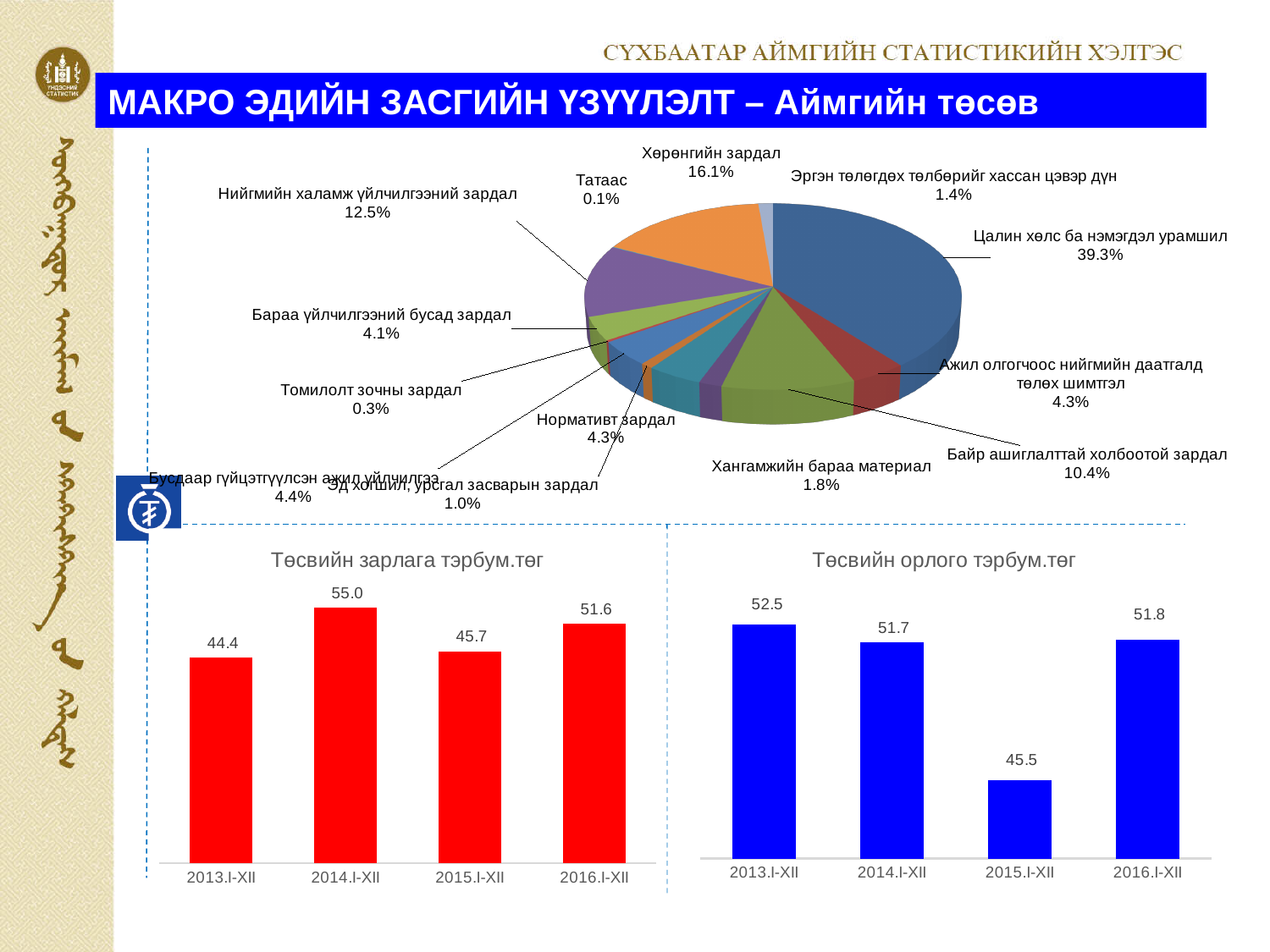
In the chart titled 'Төсвийн зарлага тэрбум.төг', what is the value for 2014.I-XII? 55.0 In the chart titled 'Төсвийн зарлага тэрбум.төг', which year has the lowest value? 2013.I-XII In the chart titled 'Төсвийн орлого тэрбум.төг', what is the value for 2015.I-XII? 45.5 In the pie chart at the top of the slide, which category has the largest share? Цалин хөлс ба нэмэгдэл урамшил In the pie chart at the top of the slide, how many slices are labelled? 13 In the chart titled 'Төсвийн орлого тэрбум.төг', is the value for 2016.I-XII larger or smaller than the value for 2015.I-XII? larger In the chart titled 'Төсвийн орлого тэрбум.төг', which year has the highest value? 2013.I-XII In the pie chart at the top of the slide, what share does Цалин хөлс ба нэмэгдэл урамшил have? 39.3% What kind of chart is 'Төсвийн орлого тэрбум.төг'? bar chart In the chart titled 'Төсвийн зарлага тэрбум.төг', what is the difference between the values for 2014.I-XII and 2013.I-XII? 10.6 In the pie chart at the top of the slide, what share does Хөрөнгийн зардал have? 16.1% In the pie chart at the top of the slide, which category has the smallest share? Татаас